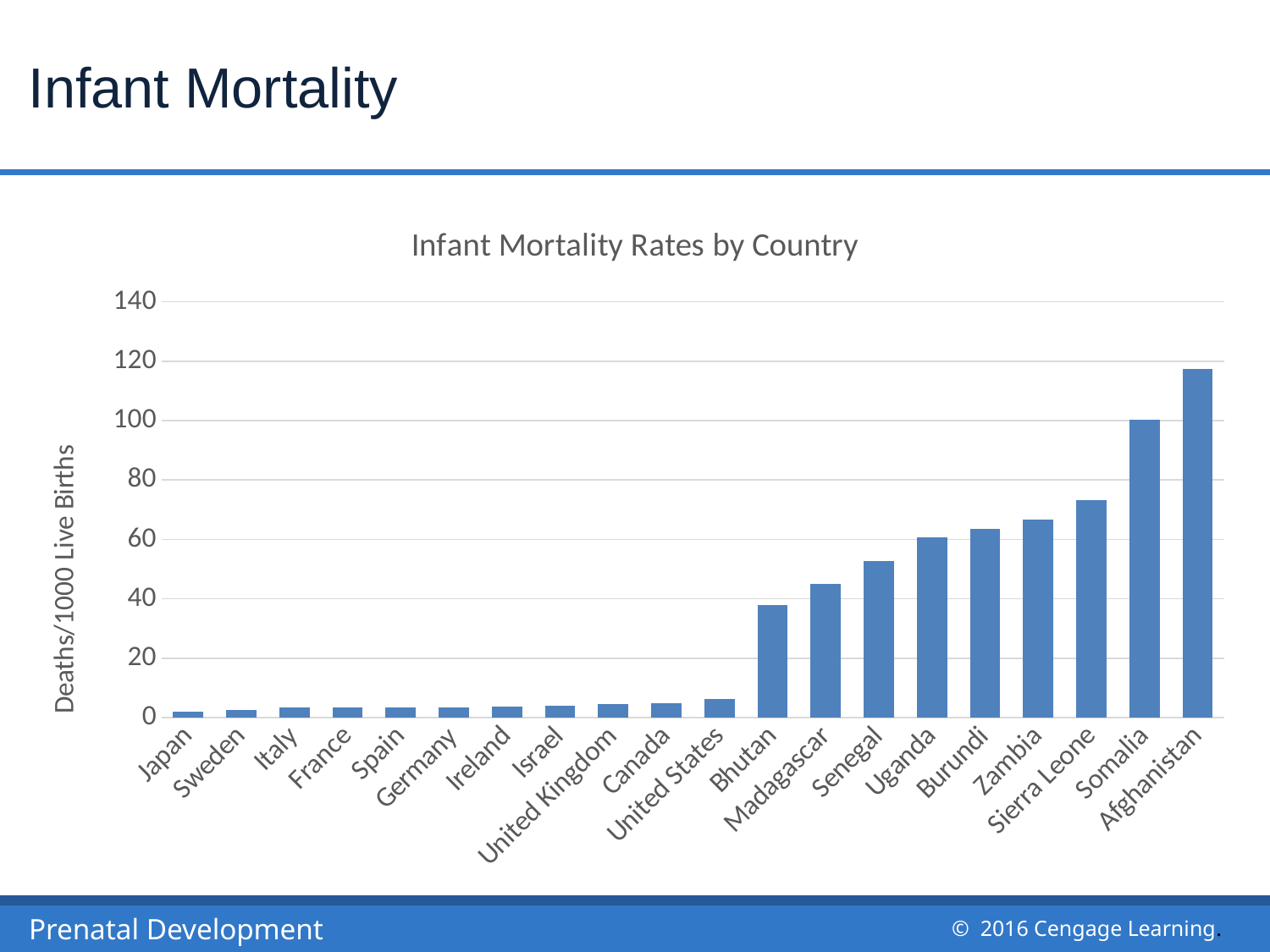
Which has a higher infant mortality rate, Zambia or Madagascar? Zambia Which country has the highest infant mortality rate in the chart? Afghanistan How many countries are shown on the x axis of the chart? 20 Do the values rise or fall moving from left to right along the x axis? rise Which country has the lowest infant mortality rate in the chart? Japan Is the value for the United States greater or less than 20? less Is the value for Sierra Leone greater or less than 60? greater What kind of chart is shown on the slide? bar chart Which has a higher infant mortality rate, Somalia or Bhutan? Somalia What is the label on the vertical axis of the chart? Deaths/1000 Live Births Is the value for Afghanistan greater or less than 100? greater